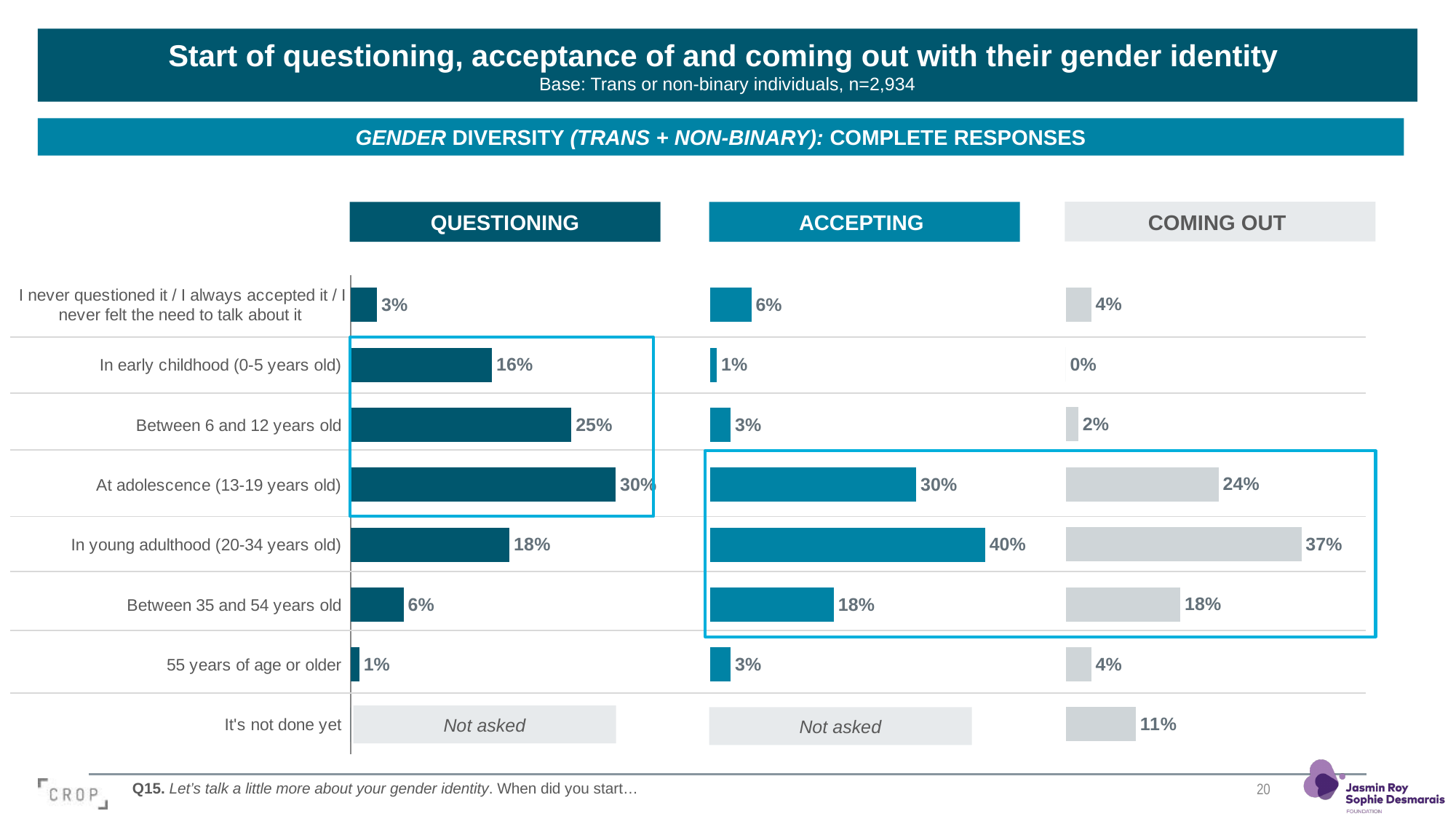
In the QUESTIONING chart, what is the difference between 'Between 6 and 12 years old' and 'In early childhood (0-5 years old)'? 9% In the QUESTIONING chart, which category has the lowest value? 55 years of age or older What type of chart is used on this slide? Bar chart For 'Between 6 and 12 years old', which is larger: the QUESTIONING value or the ACCEPTING value? QUESTIONING In the COMING OUT chart, what is the value for 'It's not done yet'? 11% In the COMING OUT chart, which category has the highest value? In young adulthood (20-34 years old) In the ACCEPTING chart, what is the difference between 'In young adulthood (20-34 years old)' and 'At adolescence (13-19 years old)'? 10% In the ACCEPTING chart, what is the value for 'In young adulthood (20-34 years old)'? 40% How many categories are listed on the left of the charts? 8 Which categories are marked 'Not asked' in the QUESTIONING and ACCEPTING charts? It's not done yet In the COMING OUT chart, what is the value for 'In early childhood (0-5 years old)'? 0% In the QUESTIONING chart, what is the value for 'At adolescence (13-19 years old)'? 30%